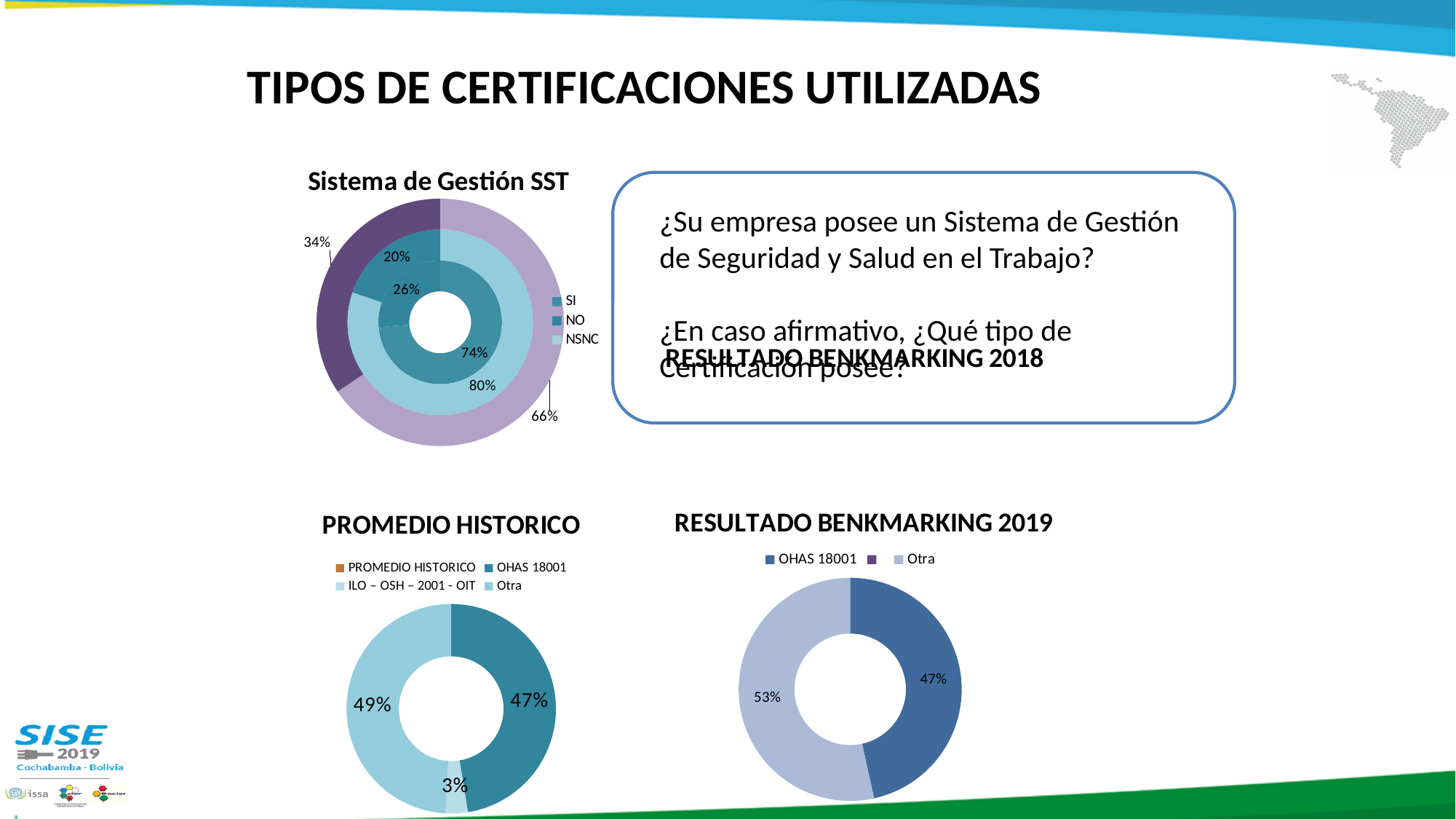
In the PROMEDIO HISTORICO chart, what is the value for OHAS 18001? 47% In the RESULTADO BENKMARKING 2019 chart, what is the difference between Otra and OHAS 18001? 6 percentage points In the RESULTADO BENKMARKING 2019 chart, which category has the largest share? Otra In the PROMEDIO HISTORICO chart, what is the value for ILO – OSH – 2001 - OIT? 3% In the PROMEDIO HISTORICO chart, what is the difference between OHAS 18001 and ILO – OSH – 2001 - OIT? 44 percentage points In the RESULTADO BENKMARKING 2019 chart, what is the value for Otra? 53% What kind of chart is the PROMEDIO HISTORICO chart? Doughnut chart In the PROMEDIO HISTORICO chart, which category has the smallest share? ILO – OSH – 2001 - OIT How many entries does the legend of the Sistema de Gestión SST chart list? 3 In the RESULTADO BENKMARKING 2019 chart, what is the value for OHAS 18001? 47% In the PROMEDIO HISTORICO chart, which is larger, Otra or OHAS 18001? Otra In the PROMEDIO HISTORICO chart, what is the value for Otra? 49%